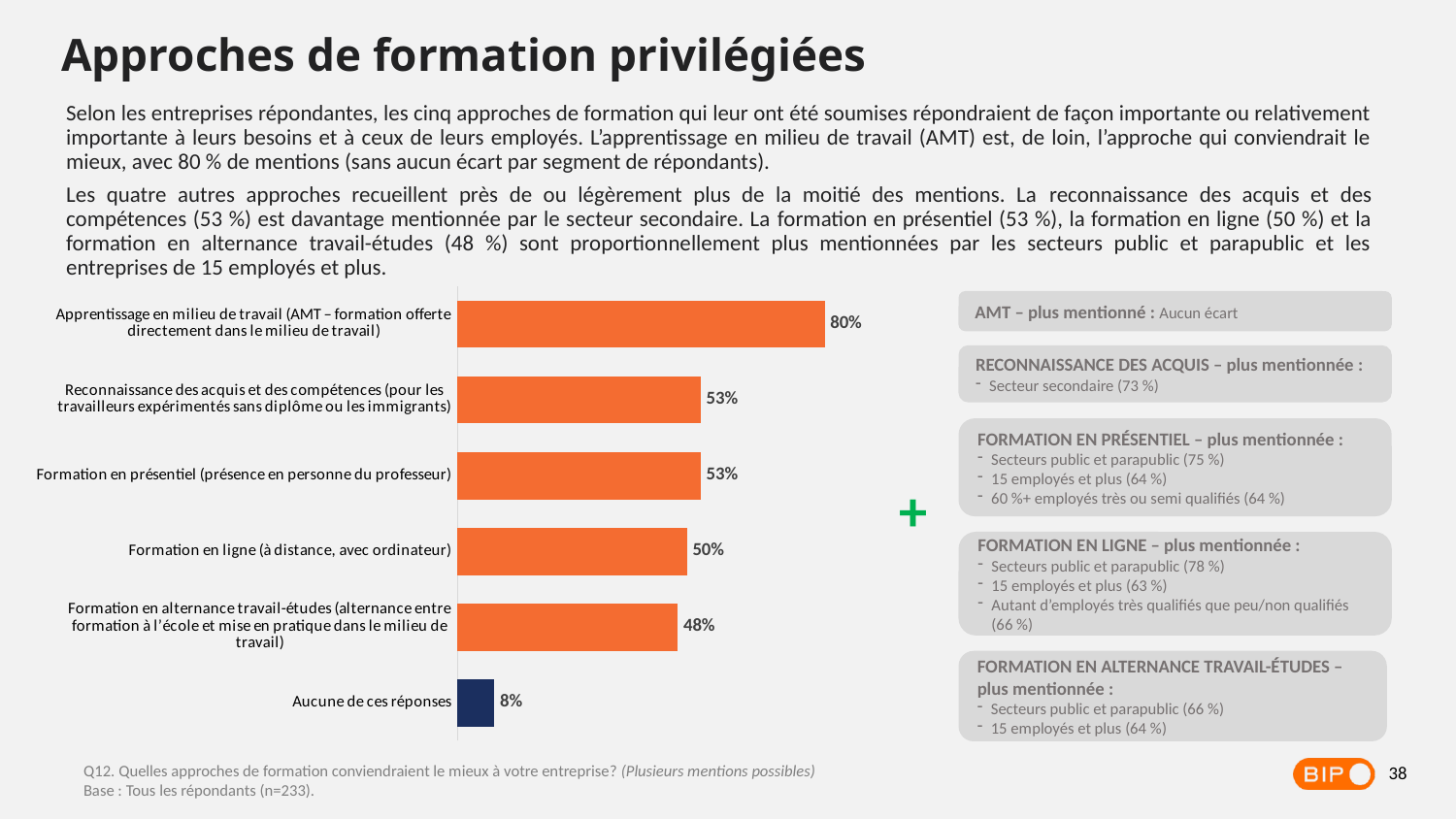
What colour is the bar for 'Aucune de ces réponses'? Dark blue Which is larger: the value for 'Formation en ligne' or the value for 'Aucune de ces réponses'? Formation en ligne What is the value shown for 'Formation en alternance travail-études'? 48% What is the value shown for 'Formation en ligne (à distance, avec ordinateur)'? 50% What is the difference between the value for 'Formation en ligne' and the value for 'Formation en alternance travail-études'? 2% What percentage of respondents mentioned 'Apprentissage en milieu de travail (AMT)'? 80% Which category has the lowest value in the chart? Aucune de ces réponses How many categories are shown in the bar chart? 6 What is the difference between the value for 'Apprentissage en milieu de travail (AMT)' and the value for 'Formation en présentiel'? 27% What type of chart is shown on the slide? Bar chart Which category has the highest value in the chart? Apprentissage en milieu de travail (AMT – formation offerte directement dans le milieu de travail) What is the value shown for 'Aucune de ces réponses'? 8%